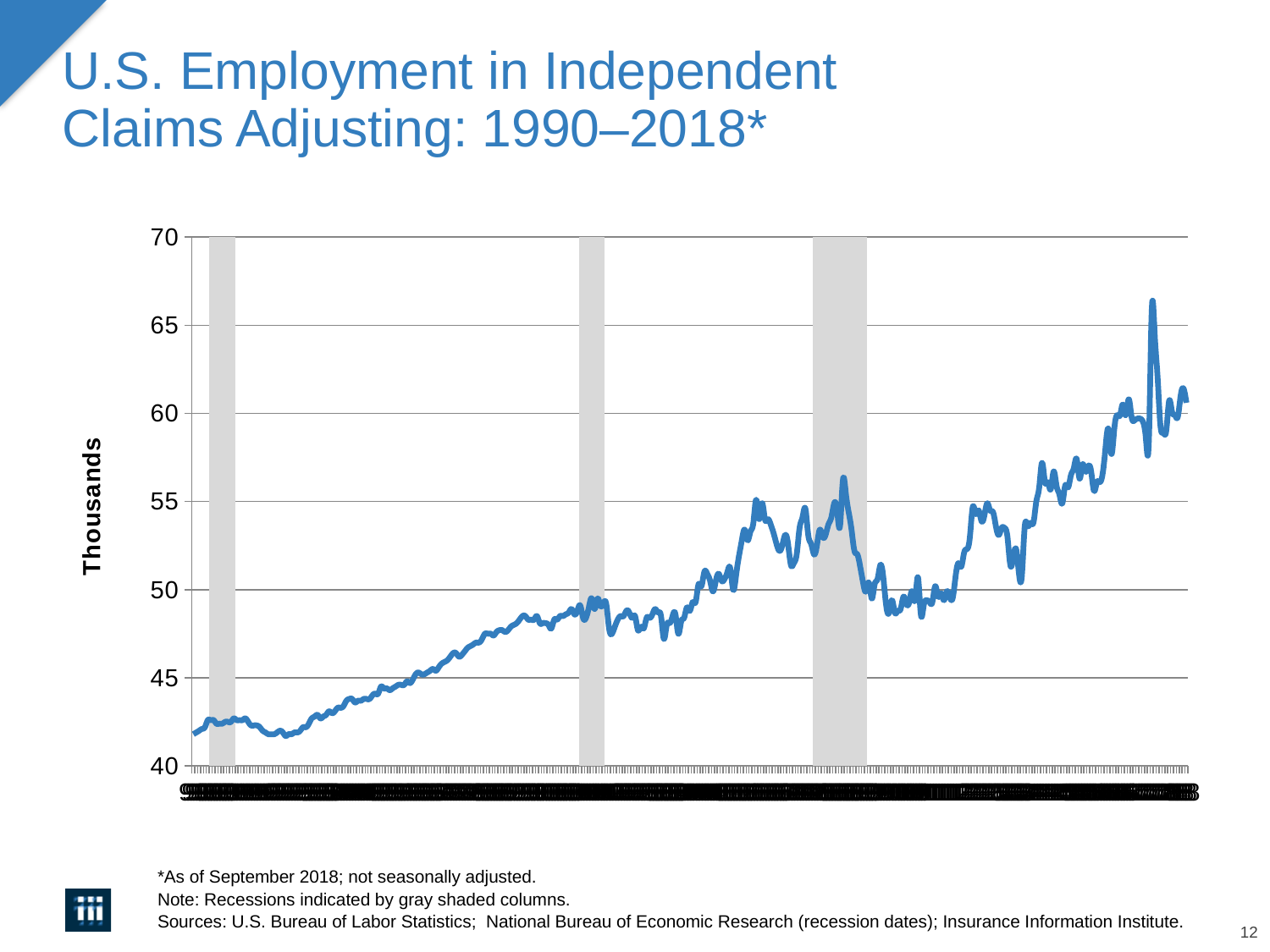
What kind of chart is shown on the slide? line chart What is the highest value shown on the vertical axis? 70 What is the lowest value shown on the vertical axis? 40 Is the lowest point reached by the line greater or less than 45? less What is the label on the vertical axis of the chart? Thousands Is the highest point reached by the line greater or less than 65? greater How many gray shaded recession columns appear on the chart? 3 Overall, does the line rise or fall from the left of the chart to the right? rise Is the value at the far right end of the line greater or less than 60? greater